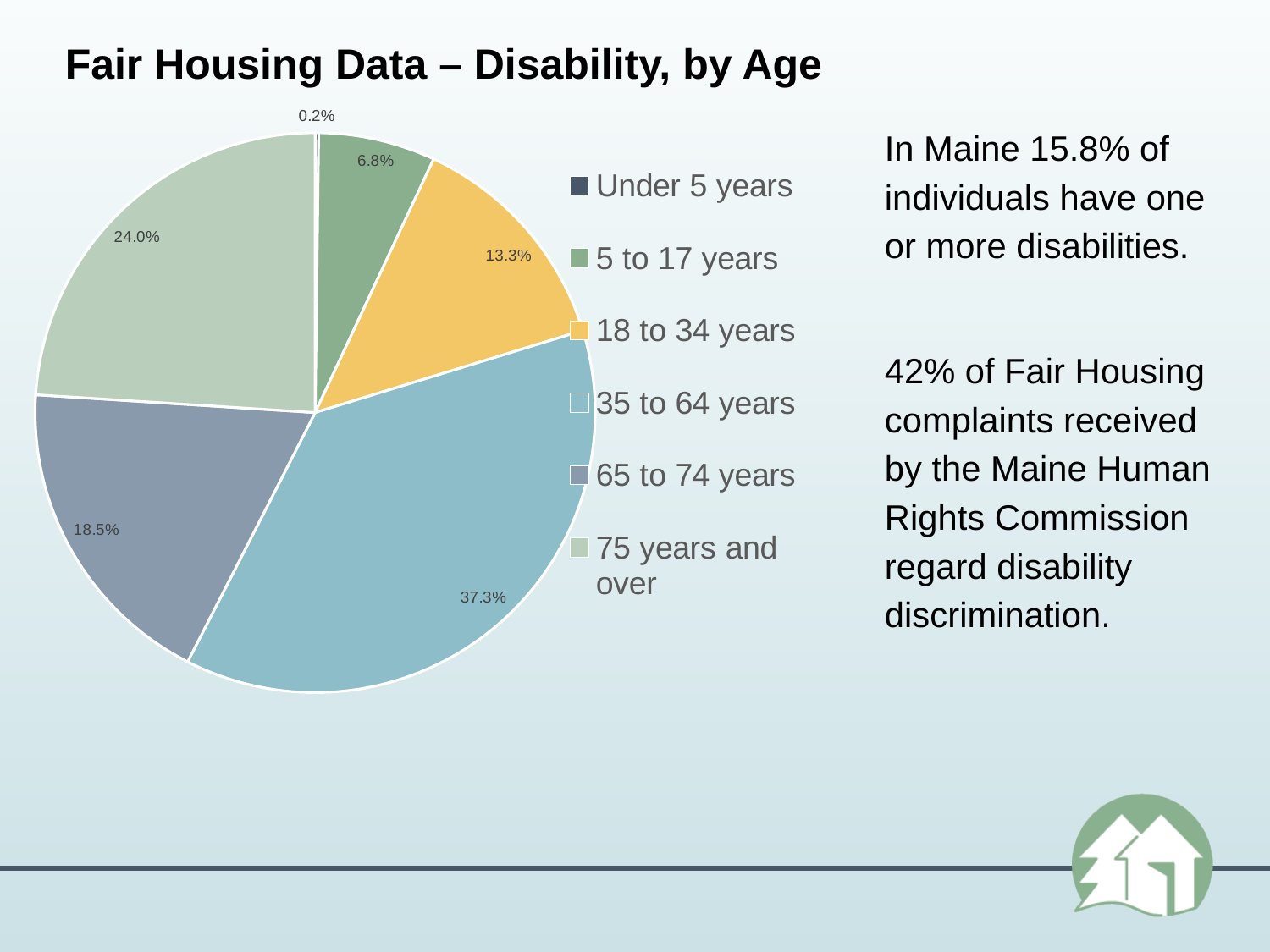
What is the difference in percentage points between the 75 years and over slice and the 65 to 74 years slice? 5.5 Which age group has the smallest slice of the pie? Under 5 years Which slice is larger, 65 to 74 years or 5 to 17 years? 65 to 74 years Which age group has the largest slice of the pie? 35 to 64 years What share of the pie is labelled for Under 5 years? 0.2% What share of the pie is labelled for 75 years and over? 24.0% What is the difference in percentage points between the 35 to 64 years slice and the 18 to 34 years slice? 24.0 What is the title of the slide containing the pie chart? Fair Housing Data – Disability, by Age How many age groups does the legend list? 6 What share of the pie is labelled for 18 to 34 years? 13.3% What kind of chart is shown on the slide? Pie chart What share of the pie is labelled for 35 to 64 years? 37.3%